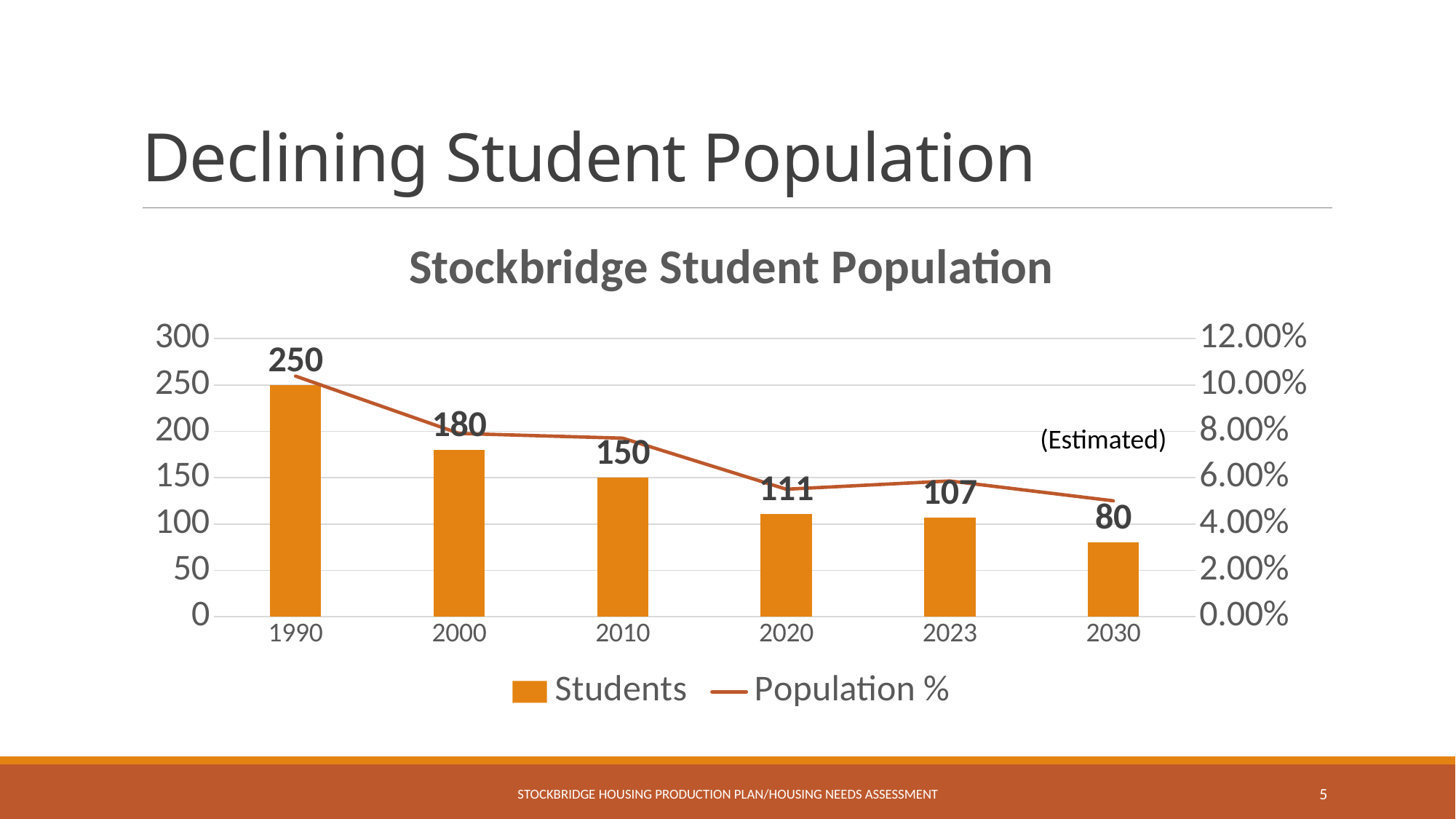
Which year has the lowest number of Students? 2030 How many series does the legend list? 2 How many years are shown on the x axis? 6 What is the number of Students in 1990? 250 What is the difference in Students between 1990 and 2000? 70 Which year has the highest number of Students? 1990 What is the estimated number of Students in 2030? 80 Is the Population % value for 1990 greater or less than 8.00%? greater What is the number of Students in 2023? 107 What is the difference in Students between 2010 and 2020? 39 Which year has more Students, 2000 or 2010? 2000 What is the title of the chart? Stockbridge Student Population